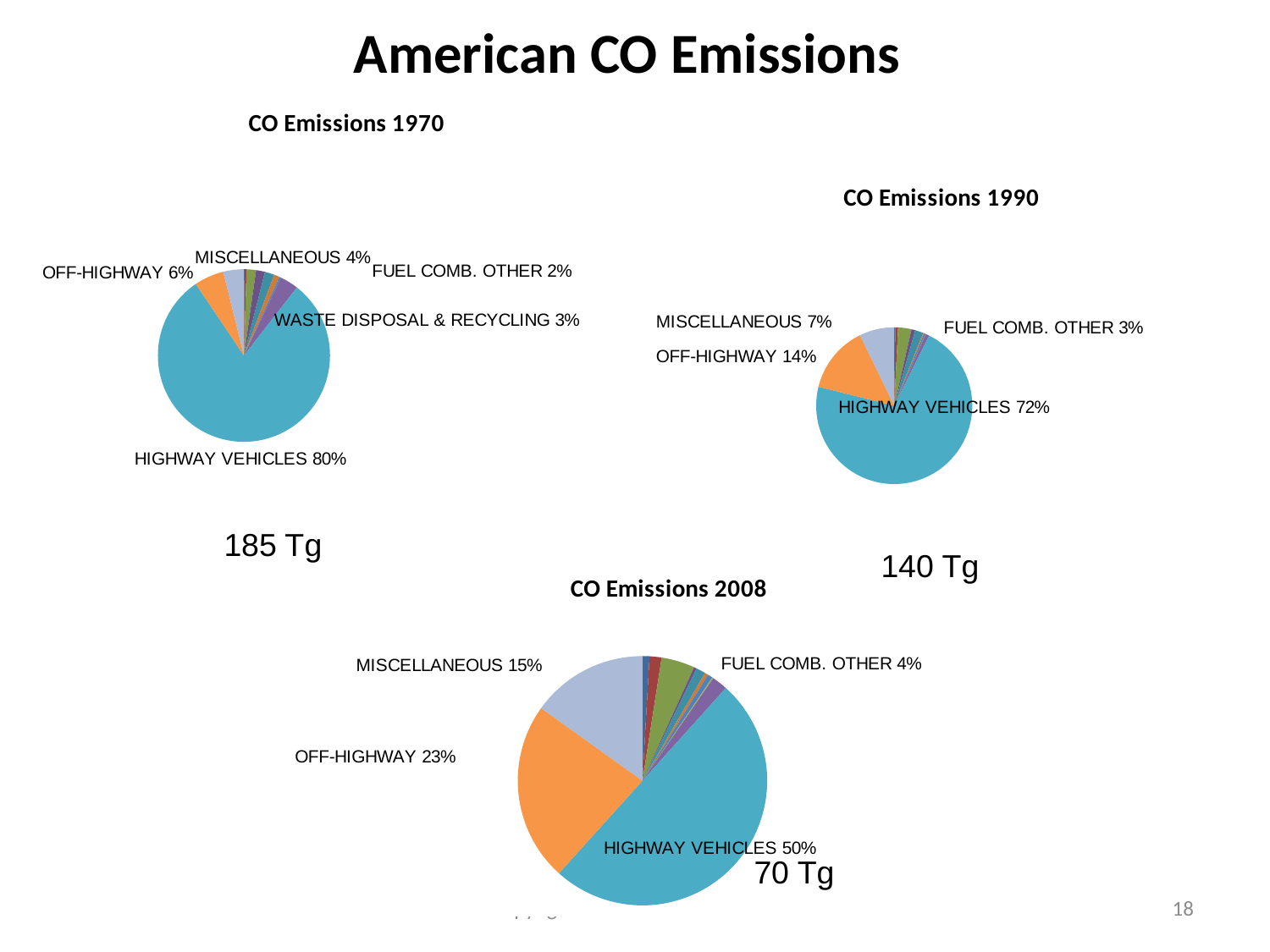
Which is larger: the OFF-HIGHWAY share in the CO Emissions 1970 chart or the OFF-HIGHWAY share in the CO Emissions 2008 chart? CO Emissions 2008 What total emissions figure is printed next to the CO Emissions 2008 chart? 70 Tg In the CO Emissions 1970 chart, what share does WASTE DISPOSAL & RECYCLING have? 3% In the CO Emissions 1990 chart, what share does OFF-HIGHWAY have? 14% How many pie charts are shown on the slide? 3 In the CO Emissions 1990 chart, which labelled category has the smallest share? FUEL COMB. OTHER In the CO Emissions 2008 chart, which labelled category has the largest share? HIGHWAY VEHICLES In the CO Emissions 1970 chart, what share does HIGHWAY VEHICLES have? 80% In the CO Emissions 2008 chart, what is the difference between the HIGHWAY VEHICLES share and the OFF-HIGHWAY share? 27% What total emissions figure is printed beneath the CO Emissions 1970 chart? 185 Tg What kind of chart is the CO Emissions 1990 chart? pie chart